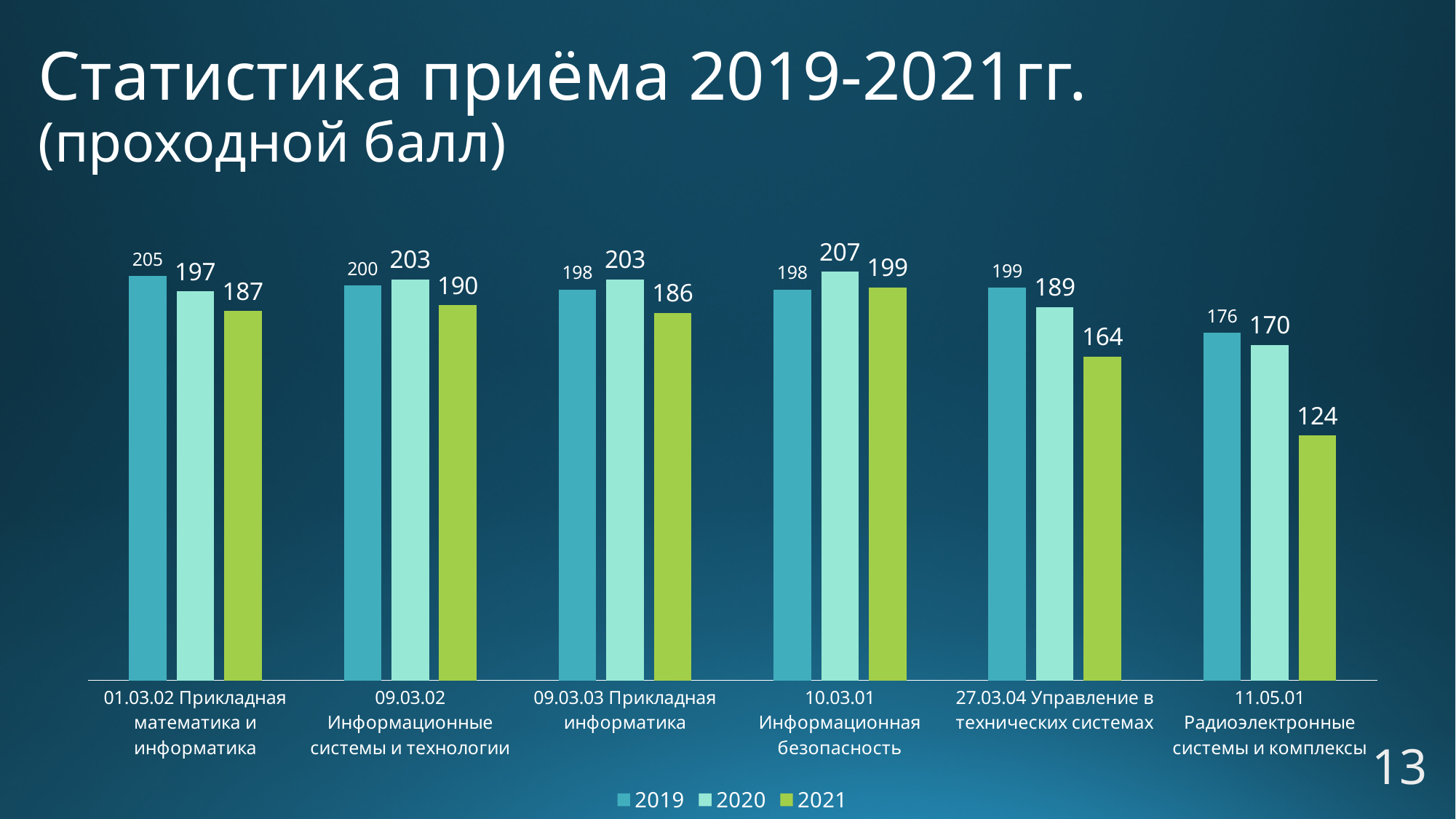
Which category has the highest 2020 value? 10.03.01 Информационная безопасность How many series does the legend list? 3 What is the 2019 value for 01.03.02 Прикладная математика и информатика? 205 Which series is shown in green in the legend? 2021 What is the 2021 value for 11.05.01 Радиоэлектронные системы и комплексы? 124 How many categories are shown on the x axis? 6 What kind of chart is shown on the slide? Bar chart Which is larger for 09.03.02 Информационные системы и технологии: the 2019 value or the 2020 value? 2020 What is the 2020 value for 10.03.01 Информационная безопасность? 207 Which category has the lowest 2021 value? 11.05.01 Радиоэлектронные системы и комплексы Do the 2021 values rise or fall from 10.03.01 Информационная безопасность to 11.05.01 Радиоэлектронные системы и комплексы? Fall What is the difference between the 2019 and 2021 values for 27.03.04 Управление в технических системах? 35